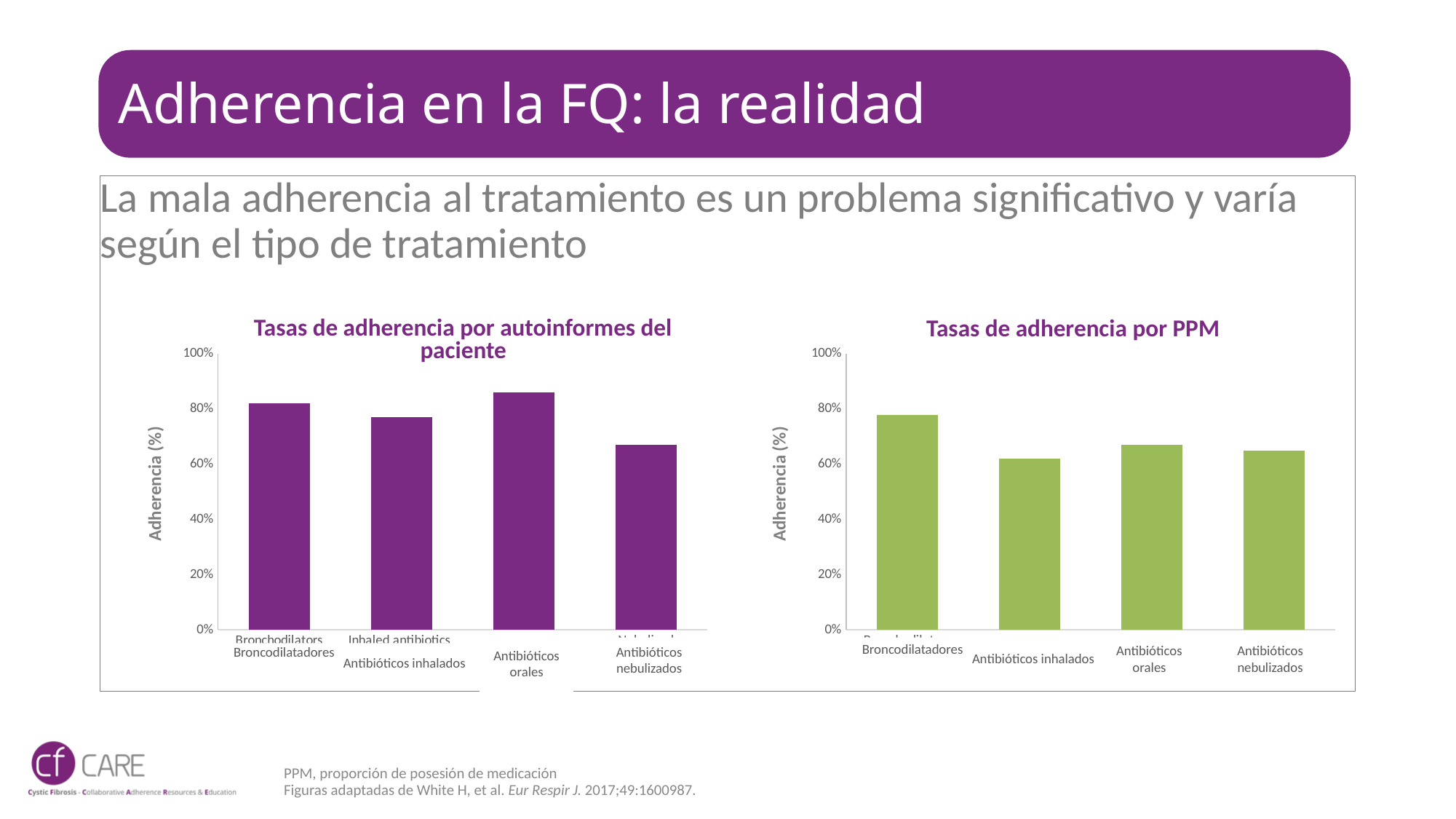
What kind of chart is the 'Tasas de adherencia por PPM' chart? bar chart What is the y-axis label of the 'Tasas de adherencia por PPM' chart? Adherencia (%) In the 'Tasas de adherencia por autoinformes del paciente' chart, which category has the highest adherence? Antibióticos orales In the 'Tasas de adherencia por PPM' chart, which category has the highest adherence? Broncodilatadores In the 'Tasas de adherencia por PPM' chart, which is larger: the value for Broncodilatadores or for Antibióticos inhalados? Broncodilatadores In the 'Tasas de adherencia por autoinformes del paciente' chart, which is larger: the value for Antibióticos inhalados or for Antibióticos nebulizados? Antibióticos inhalados How many categories are shown in the 'Tasas de adherencia por autoinformes del paciente' chart? 4 In the 'Tasas de adherencia por PPM' chart, is the value for Antibióticos orales greater or less than 80%? less In the 'Tasas de adherencia por autoinformes del paciente' chart, is the value for Antibióticos orales greater or less than 80%? greater In the 'Tasas de adherencia por autoinformes del paciente' chart, is the value for Antibióticos nebulizados greater or less than 80%? less In the 'Tasas de adherencia por autoinformes del paciente' chart, which category has the lowest adherence? Antibióticos nebulizados